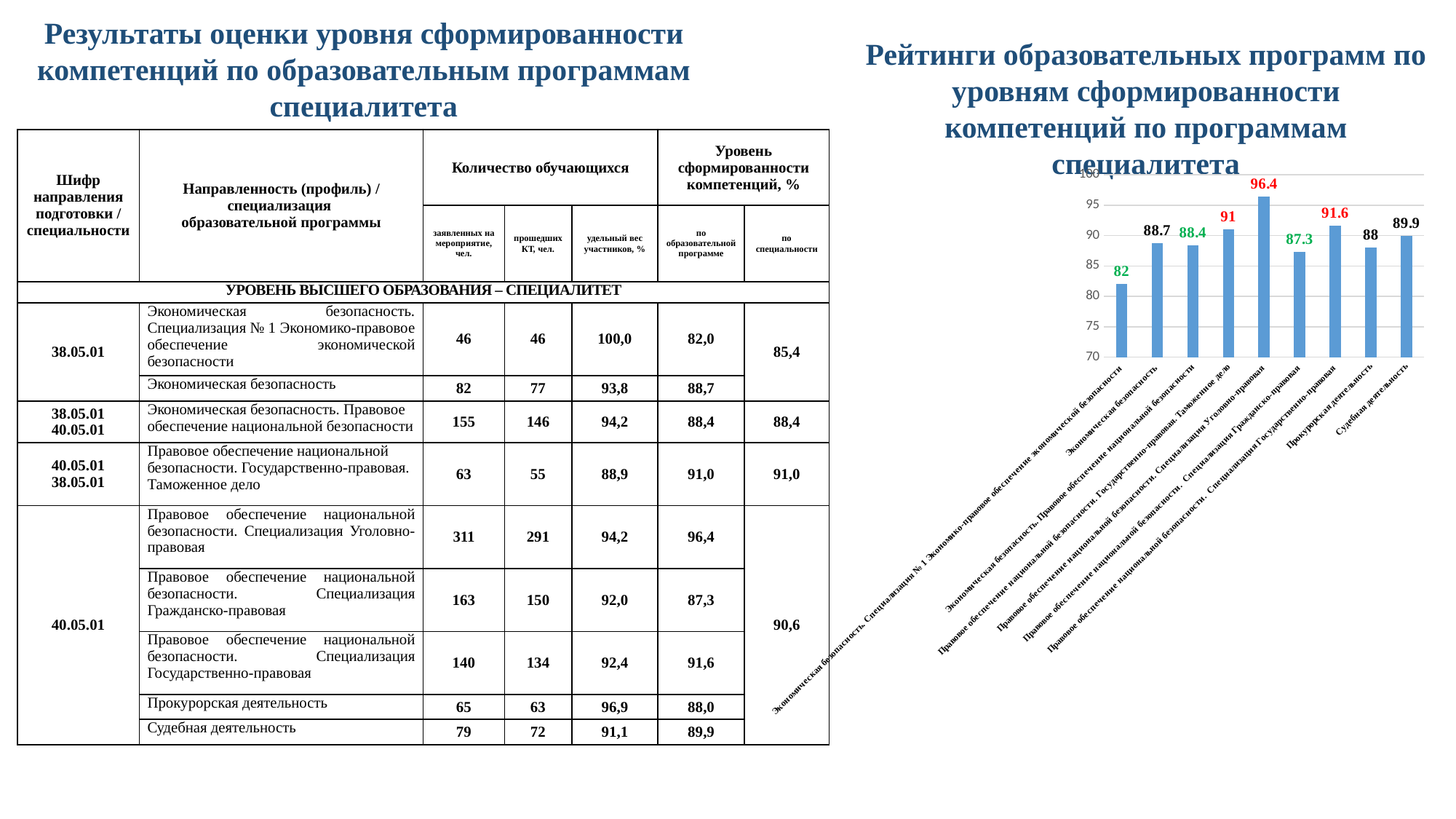
What kind of chart is shown on the right side of the slide? bar chart How many bars are plotted in the chart on the right? 9 In the bar chart, what is the value for Прокурорская деятельность? 88 In the bar chart, what is the value for Судебная деятельность? 89.9 What is the lowest value shown in the bar chart? 82 What is the highest value shown in the bar chart? 96.4 In the bar chart, which is larger: Прокурорская деятельность or Судебная деятельность? Судебная деятельность What is the difference between the highest and lowest values in the bar chart? 14.4 What colour are the bars in the chart? blue In the bar chart, what is the difference between Судебная деятельность and Прокурорская деятельность? 1.9 In the bar chart, what is the value for Экономическая безопасность (second bar)? 88.7 Is the value of the first bar in the chart greater or less than 85? less